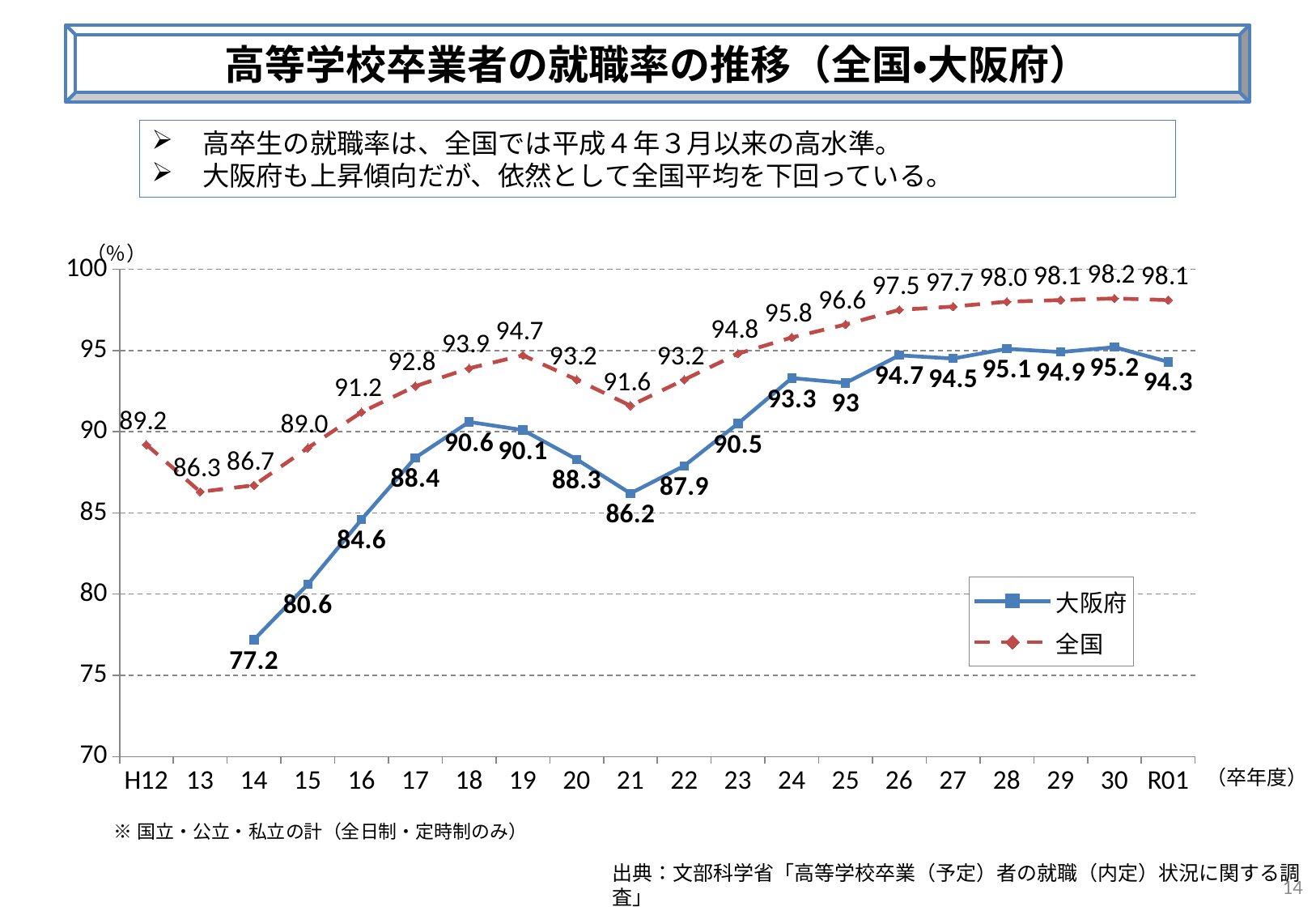
Does the 大阪府 series generally rise or fall from 14 to 18? rise In which year does the 全国 series reach its highest value? 30 In which year does the 大阪府 series have its lowest value? 14 What type of chart is shown on the slide? line chart What is the difference between 全国 and 大阪府 in R01? 3.8 How many series does the legend list? 2 What is the value for 全国 in R01? 98.1 How many years are shown on the x axis? 20 What is the value for 大阪府 in 21? 86.2 Which series has the higher value in 18, 大阪府 or 全国? 全国 What is the value for 大阪府 in 14? 77.2 What is the title of the chart? 高等学校卒業者の就職率の推移（全国・大阪府）